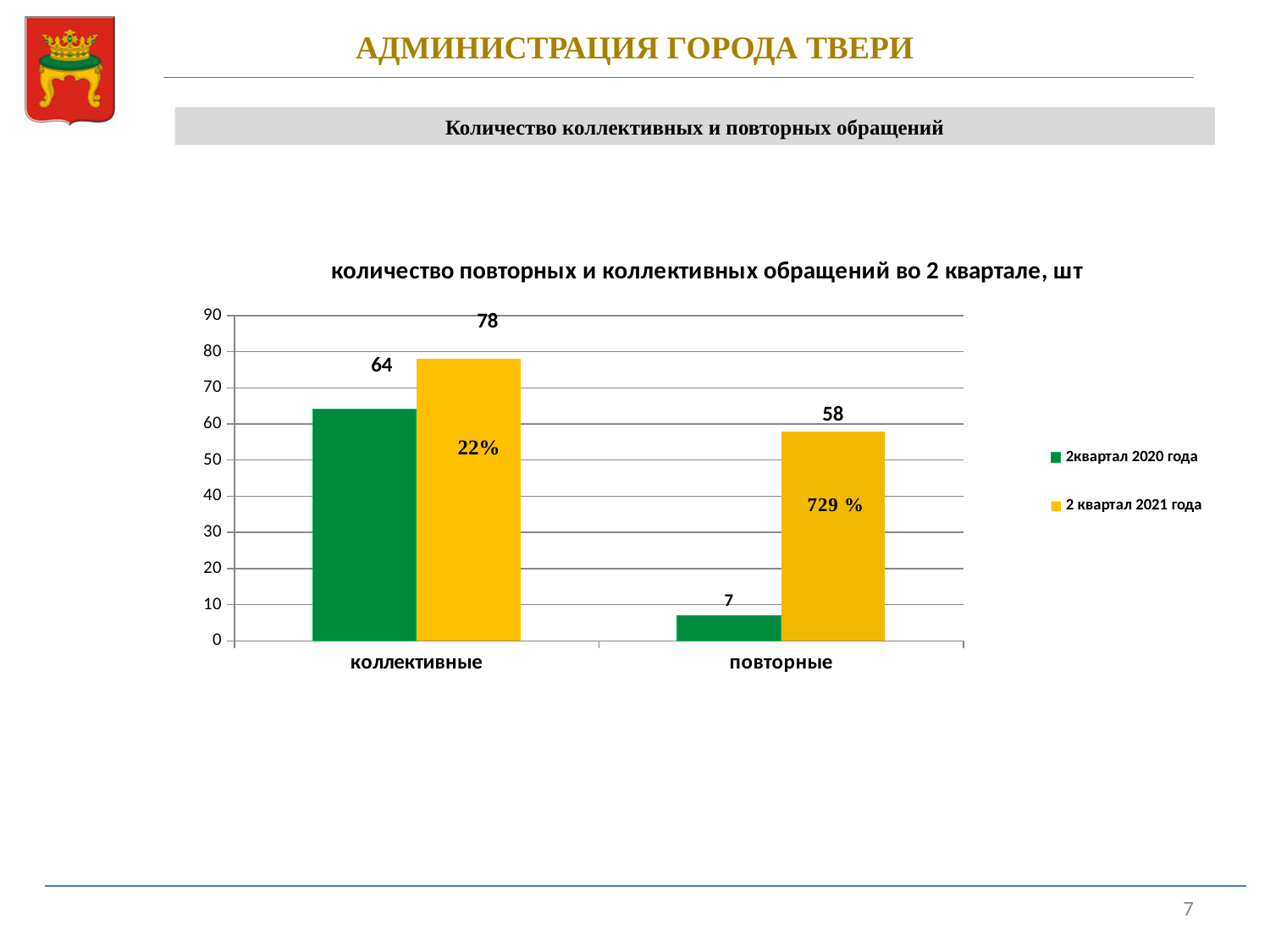
What is the difference between the 2 квартал 2021 года and 2квартал 2020 года values for повторные? 51 Which is larger for коллективные: the 2квартал 2020 года value or the 2 квартал 2021 года value? 2 квартал 2021 года What kind of chart is shown on the slide? bar chart Which category has the lowest value in 2квартал 2020 года? повторные What is the value for коллективные in 2 квартал 2021 года? 78 How many categories are shown on the x axis? 2 What is the difference between the 2 квартал 2021 года and 2квартал 2020 года values for коллективные? 14 Which category has the highest value in 2 квартал 2021 года? коллективные What is the value for повторные in 2 квартал 2021 года? 58 What is the value for коллективные in 2квартал 2020 года? 64 What is the value for повторные in 2квартал 2020 года? 7 How many series does the legend list? 2